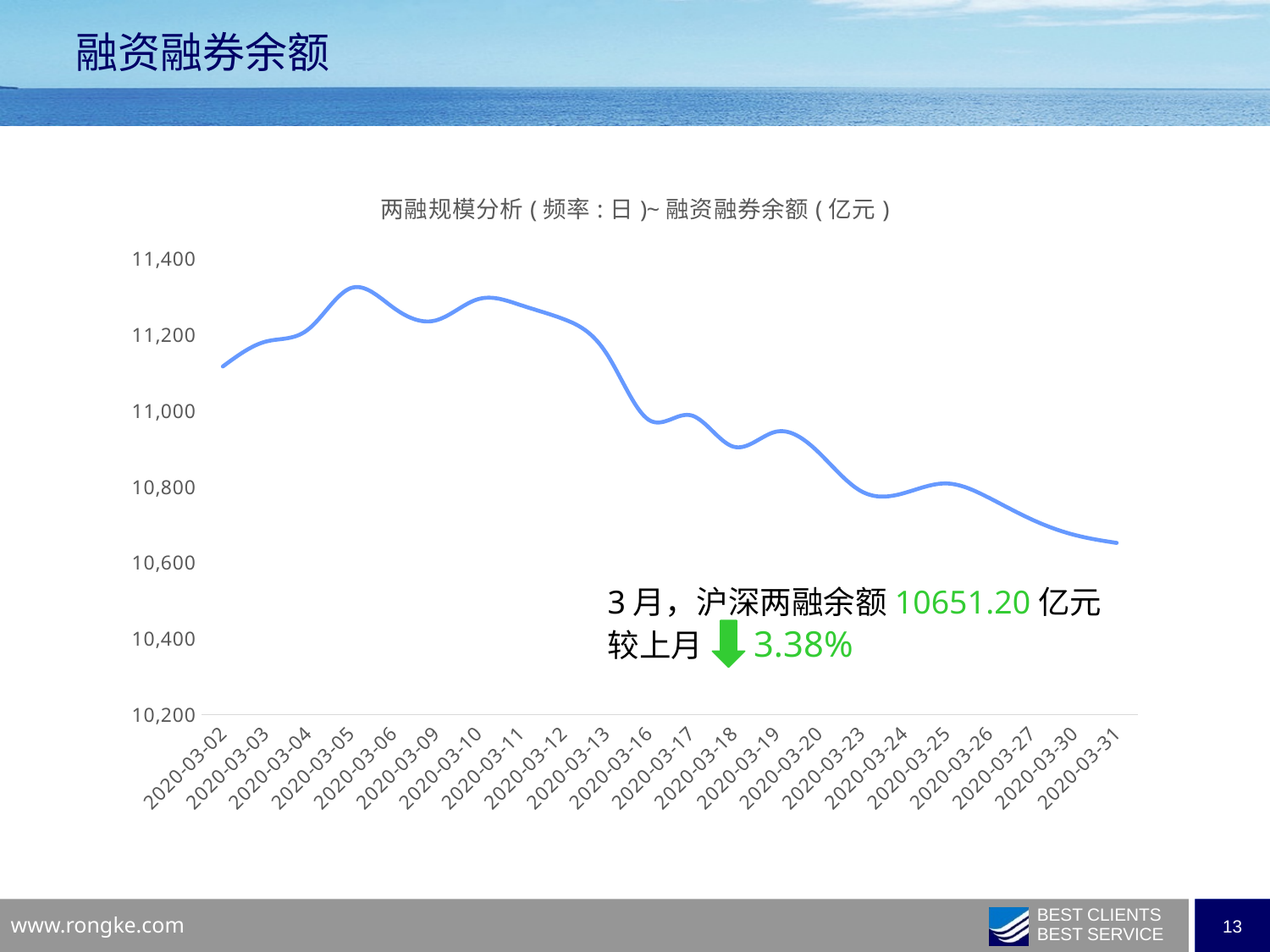
What kind of chart is shown on the slide? line chart Which is larger, the value for 2020-03-02 or the value for 2020-03-31? 2020-03-02 What is the highest value shown on the y axis of the chart? 11,400 Overall, do the values rise or fall from 2020-03-02 to 2020-03-31? fall Is the value for 2020-03-05 greater or less than 11,200? greater What is the title of the chart? 两融规模分析 ( 频率 : 日 )~ 融资融券余额 ( 亿元 ) Is the value for 2020-03-02 greater or less than 11,000? greater Is the value for 2020-03-31 greater or less than 10,800? less How many dates are plotted along the x axis of the chart? 22 Which date has the lowest value on the chart? 2020-03-31